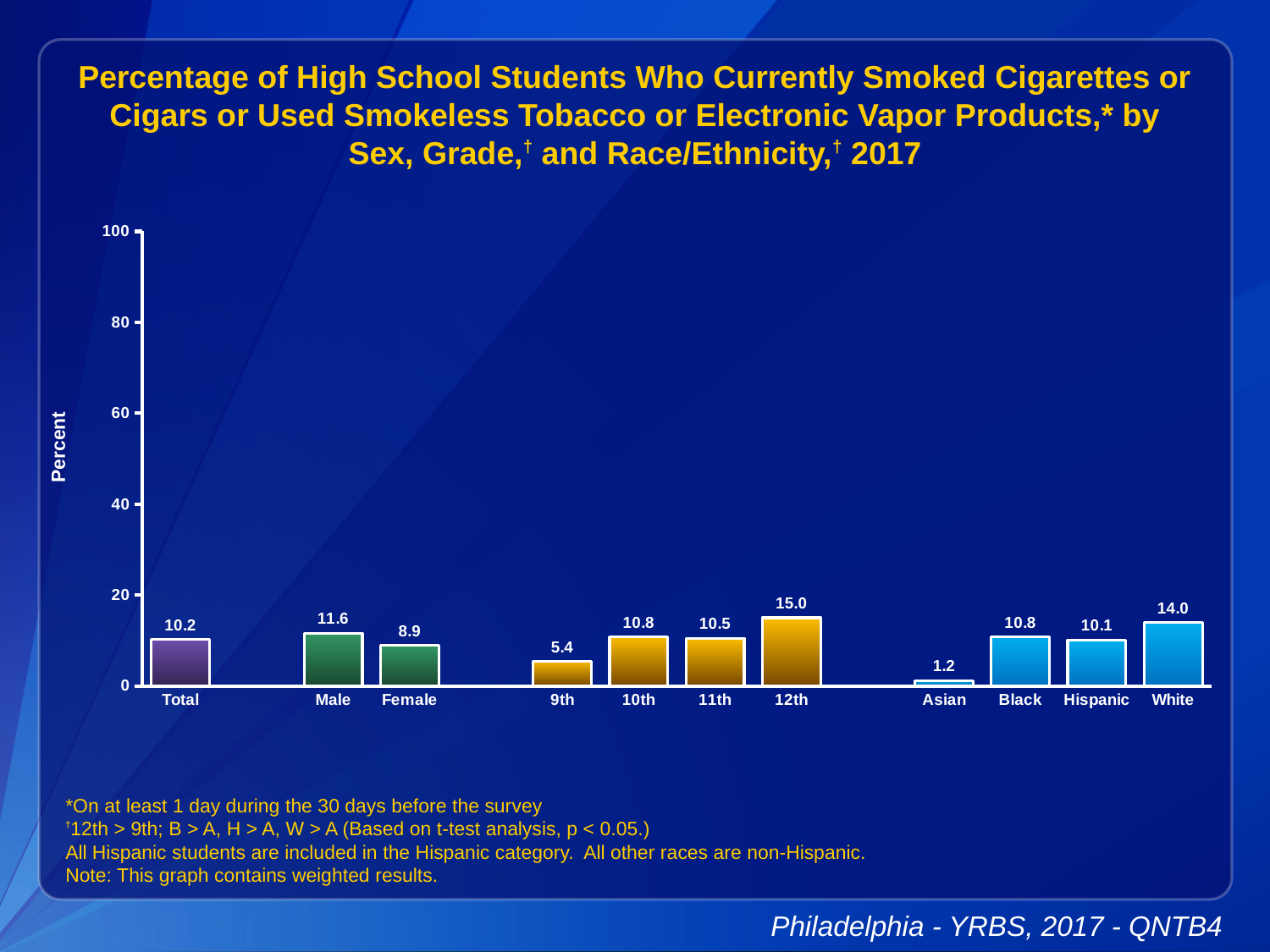
How many categories are shown on the x axis? 11 Which category has the highest value? 12th What is the difference between the 12th and 9th grade values? 9.6 What kind of chart is this? bar chart Which category has the lowest value? Asian Is the value for 12th grade greater or less than 20? less Which is larger, the value for White or the value for Black? White What is the label on the y axis? Percent What is the value for 12th grade? 15.0 What is the value for Asian students? 1.2 What is the value for Total? 10.2 What is the difference between the Male and Female values? 2.7